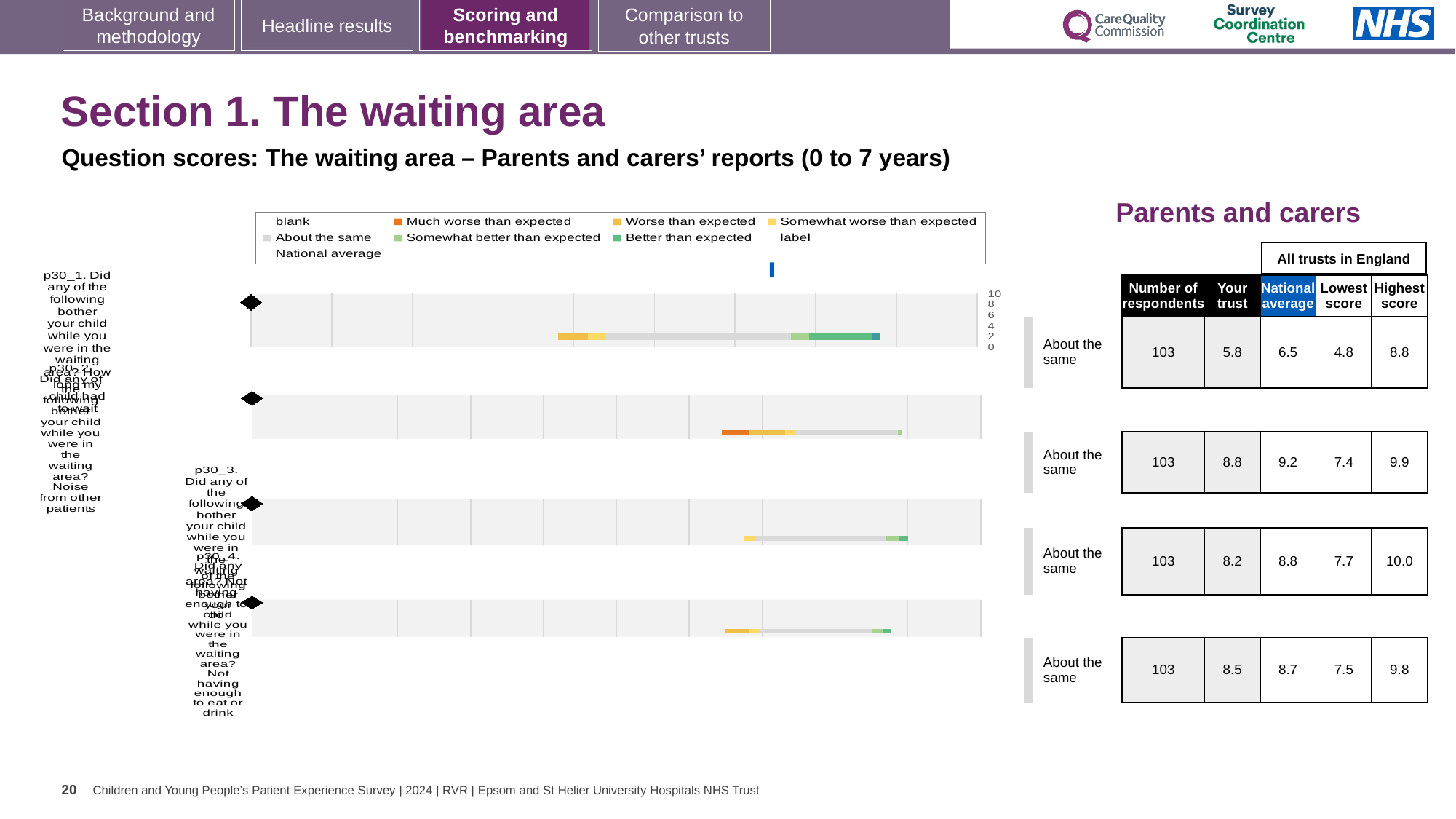
How many legend entries are listed above the charts? 9 In the table to the right of the charts, what is the difference between the highest score and the lowest score for the top row? 4.0 In the table to the right of the charts, which row has the lowest 'Your trust' score? the top row (5.8) What is the highest value shown on the x axis of the top chart? 10 In the table to the right of the charts, what is the national average for the top row (p30_1)? 6.5 In the table to the right of the charts, what is the 'Your trust' score for the top row (p30_1)? 5.8 In the table to the right of the charts, which row has the highest 'Your trust' score? the second row (8.8) What kind of chart is used to show the question scores on this slide? bar chart What colour represents 'Much worse than expected' in the legend? orange How many question bars are plotted on the slide? 4 In the table to the right of the charts, how many respondents are listed for the second row? 103 In the table to the right of the charts, is the 'Your trust' score or the national average larger for the top row? national average